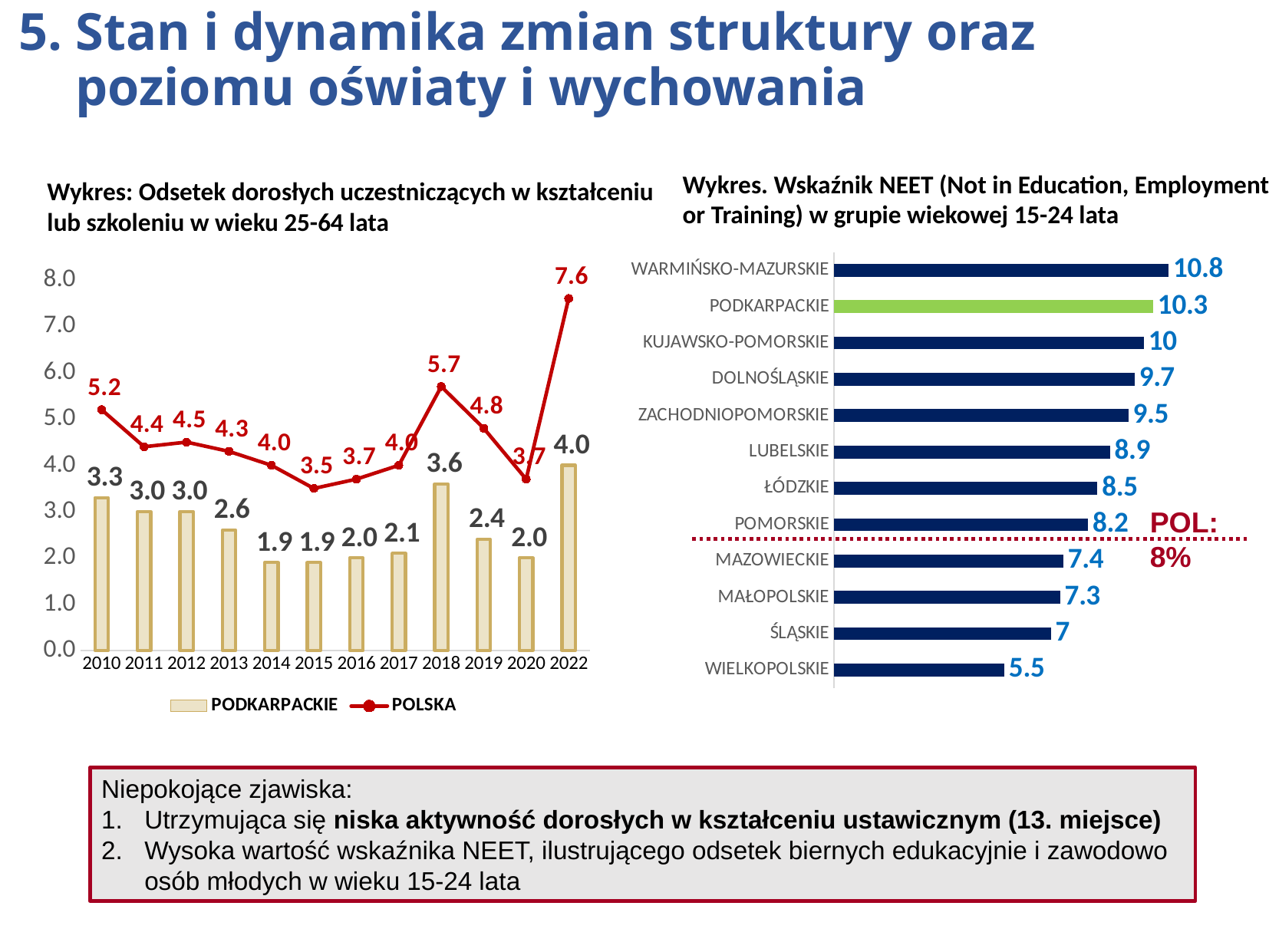
In the left chart (Odsetek dorosłych uczestniczących w kształceniu lub szkoleniu), in which year is the POLSKA value lowest? 2015 In the left chart (Odsetek dorosłych uczestniczących w kształceniu lub szkoleniu), how many series does the legend list? 2 In the right chart (Wskaźnik NEET), which voivodeship has the highest value? WARMIŃSKO-MAZURSKIE In the left chart (Odsetek dorosłych uczestniczących w kształceniu lub szkoleniu), how many years are shown on the x axis? 12 In the left chart (Odsetek dorosłych uczestniczących w kształceniu lub szkoleniu), what is the value for POLSKA in 2022? 7.6 In the left chart (Odsetek dorosłych uczestniczących w kształceniu lub szkoleniu), what is the value for PODKARPACKIE in 2018? 3.6 In the right chart (Wskaźnik NEET), which voivodeship has the lowest value? WIELKOPOLSKIE In the left chart (Odsetek dorosłych uczestniczących w kształceniu lub szkoleniu), what is the difference between the POLSKA and PODKARPACKIE values in 2022? 3.6 What type of chart is the right chart (Wskaźnik NEET)? Bar chart In the right chart (Wskaźnik NEET), which is larger: the value for LUBELSKIE or the value for MAZOWIECKIE? LUBELSKIE In the right chart (Wskaźnik NEET), what is the difference between the values for WARMIŃSKO-MAZURSKIE and WIELKOPOLSKIE? 5.3 In the right chart (Wskaźnik NEET), what is the value for PODKARPACKIE? 10.3